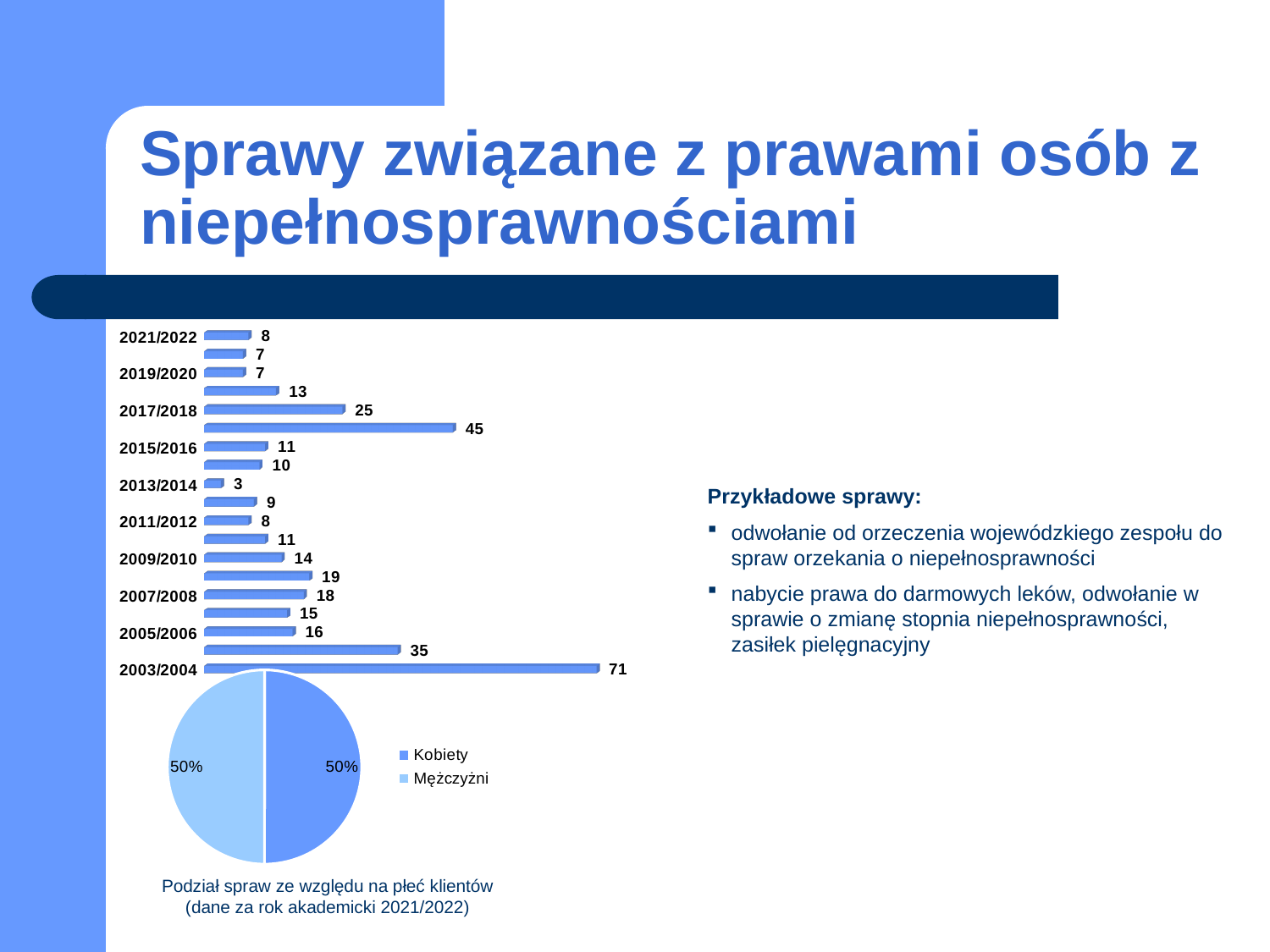
In the bar chart, what is the value for 2021/2022? 8 In the bar chart, which is larger, the value for 2009/2010 or the value for 2015/2016? 2009/2010 In the bar chart, what is the difference between the values for 2003/2004 and 2005/2006? 55 What kind of chart is the chart at the top left of the slide? bar chart In the bar chart, what is the value for 2017/2018? 25 In the bar chart, what is the value for 2013/2014? 3 In the bar chart, what is the value for 2003/2004? 71 In the bar chart, which academic year has the lowest value? 2013/2014 How many entries does the legend of the pie chart list? 2 How many bars are plotted in the bar chart? 19 In the pie chart, what share does Kobiety have? 50% In the bar chart, which academic year has the highest value? 2003/2004